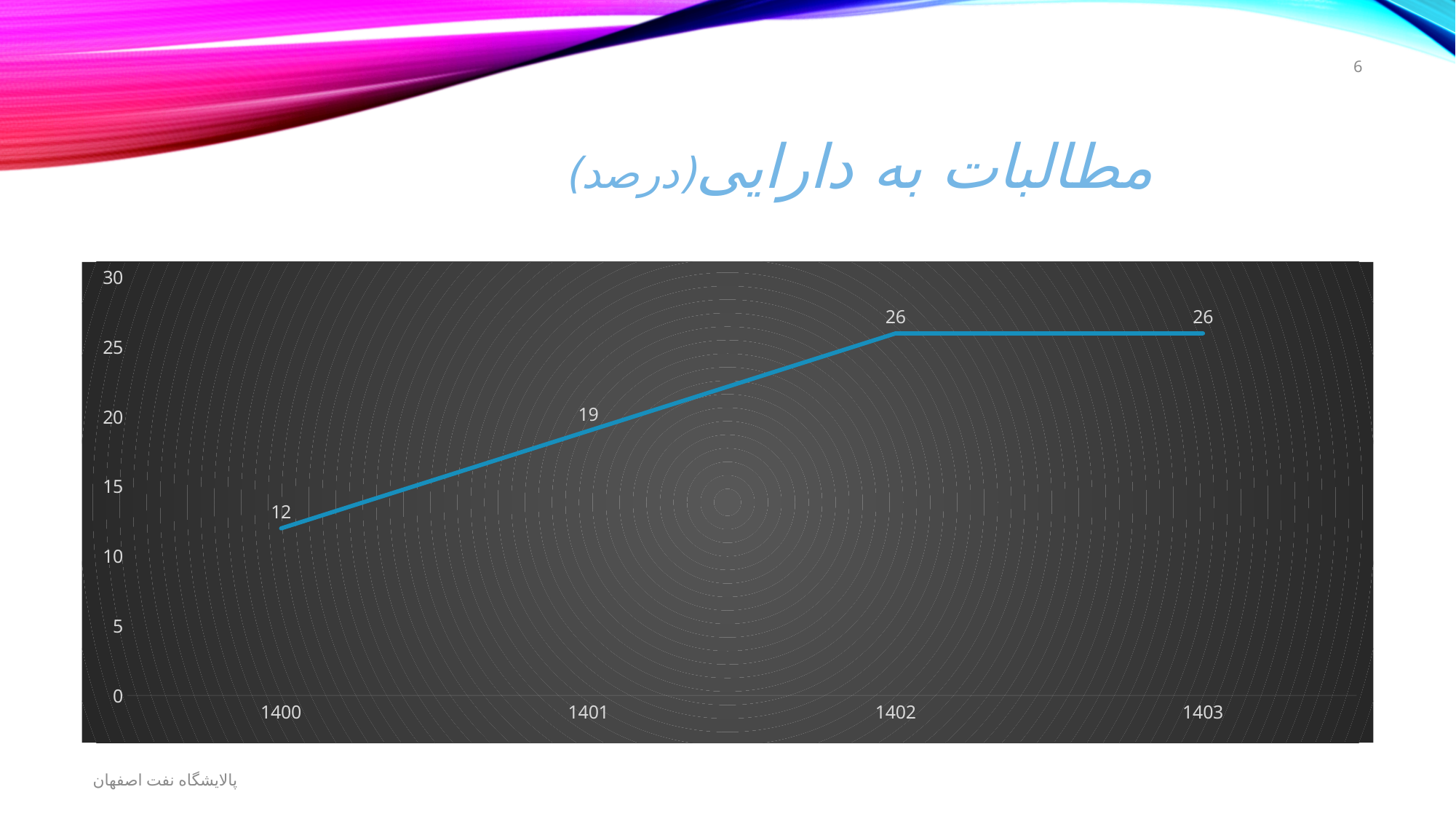
Which year has the lowest value? 1400 What is the value for 1401? 19 Do the values rise or fall from 1400 to 1402? rise What is the value for 1400? 12 What kind of chart is shown on the slide? line chart Which is larger, the value for 1401 or the value for 1402? 1402 What is the value for 1403? 26 What is the difference between the values for 1402 and 1400? 14 Is the value for 1401 greater or less than 15? greater What is the difference between the values for 1401 and 1400? 7 How many years are plotted on the x axis? 4 What is the value for 1402? 26